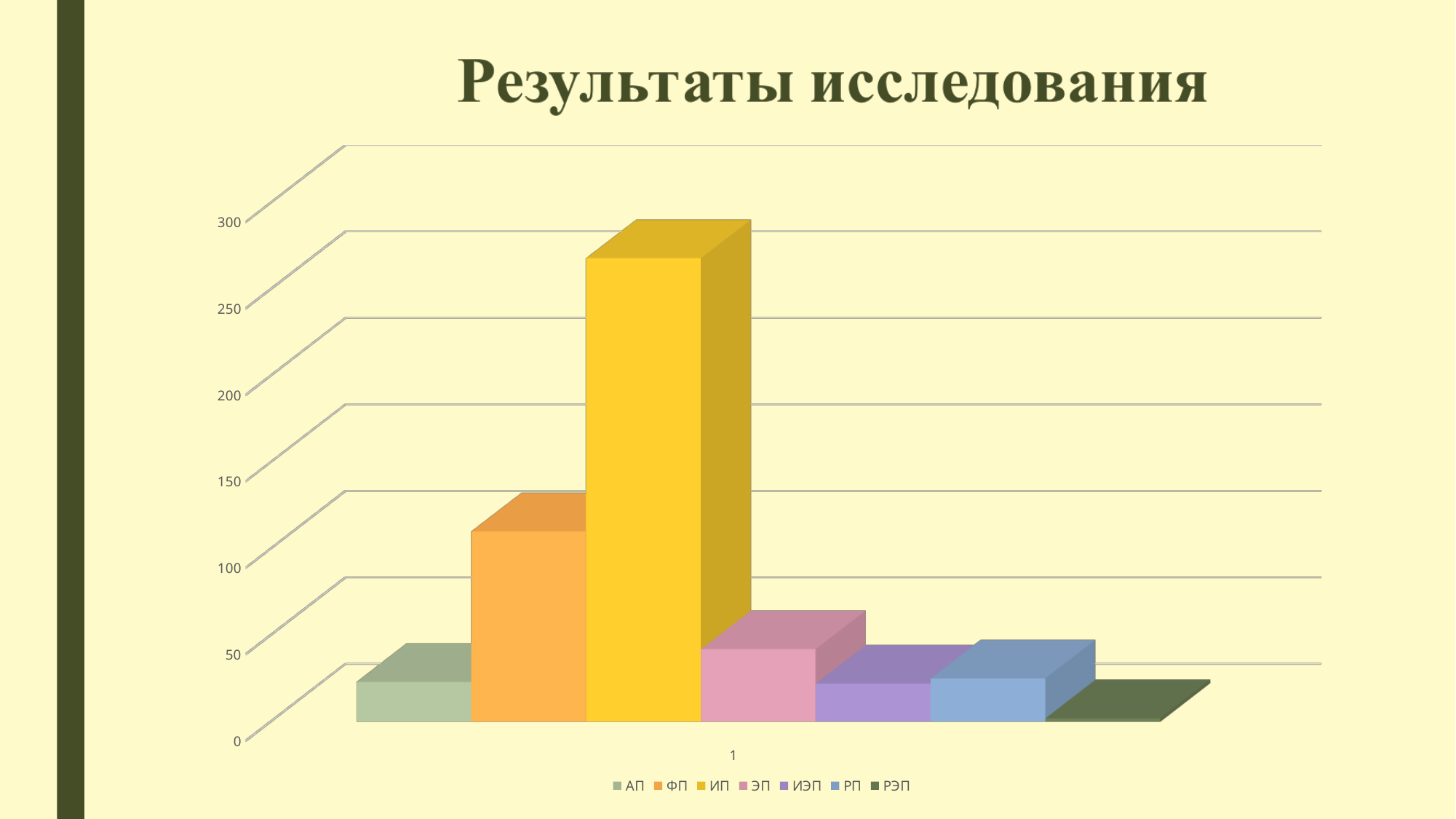
How many categories are shown on the x axis? 1 How many series does the legend list? 7 Which series has the highest bar? ИП Is the value for ФП greater or less than 100? greater Which is larger, the value for ЭП or the value for ИЭП? ЭП Is the value for ФП greater or less than 150? less Is the value for ИП greater or less than 250? greater Which is larger, the value for АП or the value for ФП? ФП What kind of chart is shown on the slide? bar chart What is the title of the chart? Результаты исследования Which series has the lowest bar? РЭП